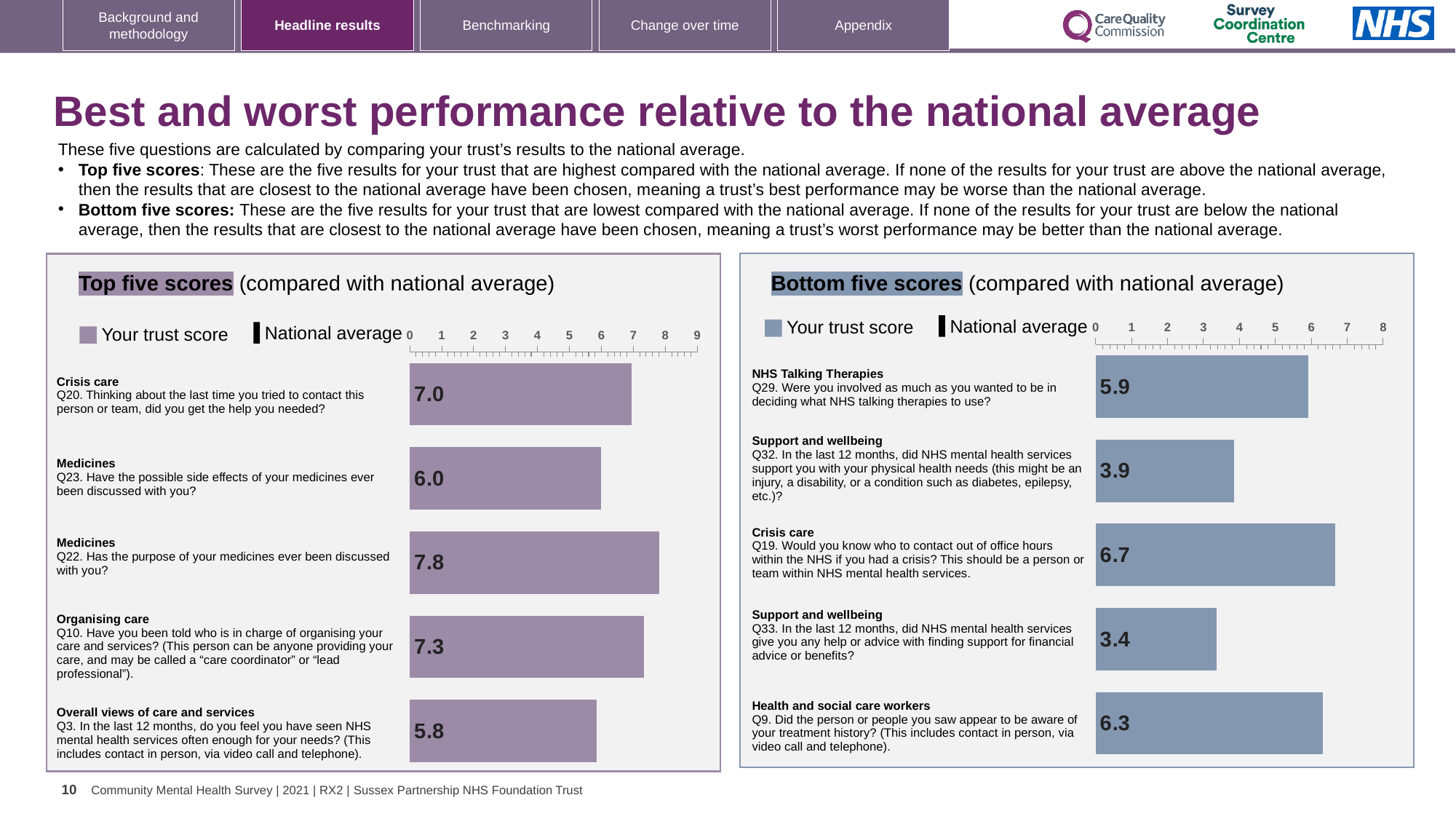
In the Top five scores chart, what is the trust score for Q22 (Has the purpose of your medicines ever been discussed with you?)? 7.8 In the Bottom five scores chart, which question has the lowest trust score? Q33 In the Top five scores chart, how many questions are plotted? 5 How many series does the legend of the Bottom five scores chart list? 2 What type of chart is the Top five scores chart? Bar chart In the Bottom five scores chart, what is the trust score for Q19 (Crisis care)? 6.7 In the Bottom five scores chart, which is larger, the score for Q29 or the score for Q9? Q9 In the Top five scores chart, what is the difference between the scores for Q22 and Q23? 1.8 In the Top five scores chart, which question has the highest trust score? Q22 In the Bottom five scores chart, what is the difference between the scores for Q19 and Q33? 3.3 In the Bottom five scores chart, what is the trust score for Q32 (Support and wellbeing, physical health needs)? 3.9 In the Top five scores chart, what is the trust score for Q3 (Overall views of care and services)? 5.8